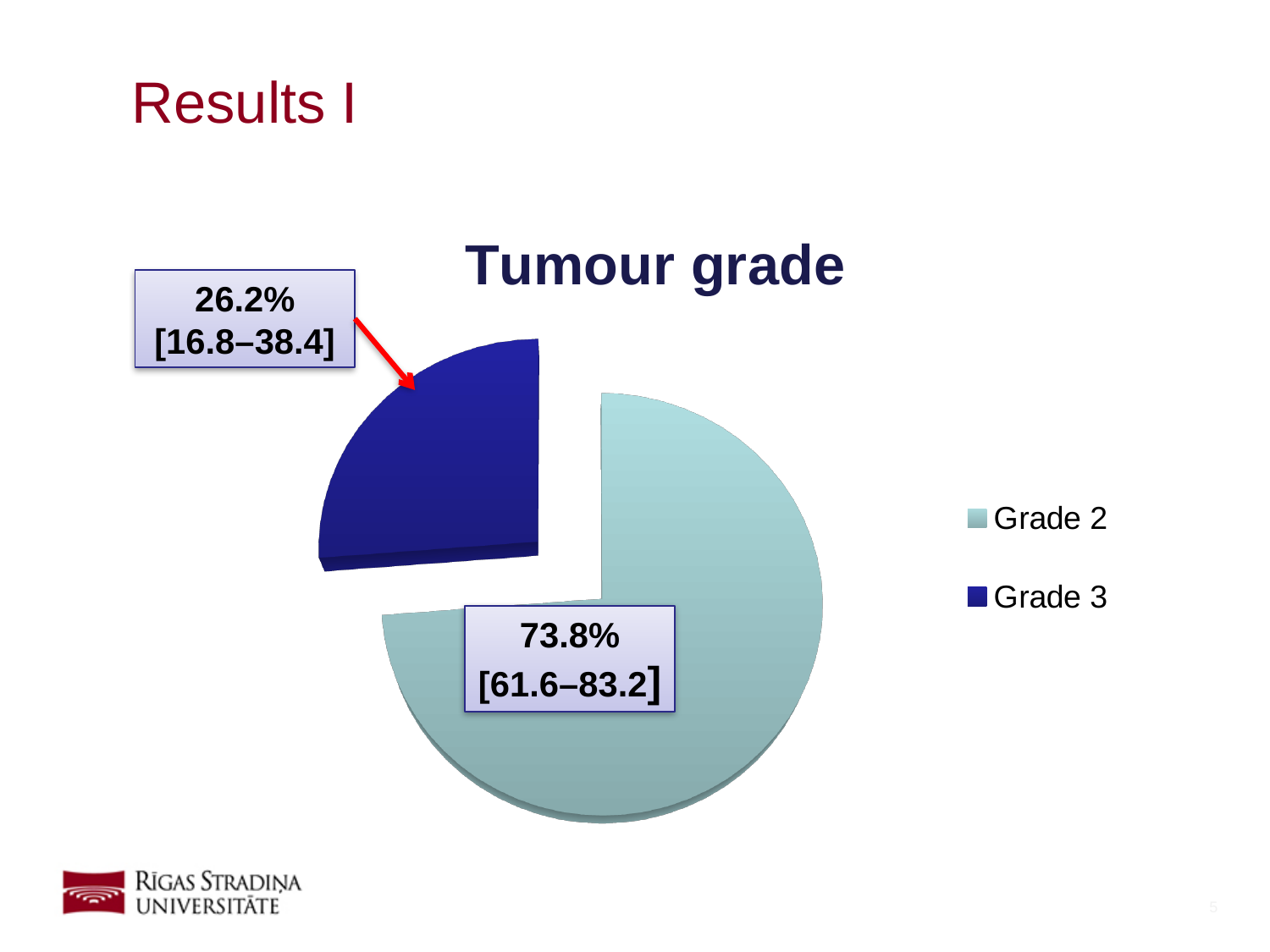
Which tumour grade has the smallest share of the pie? Grade 3 Which tumour grade has the largest share of the pie? Grade 2 How many entries does the legend list? 2 How many slices does the pie chart have? 2 What percentage of the pie is Grade 2? 73.8% What percentage of the pie is Grade 3? 26.2% What confidence interval is shown for the Grade 3 slice? [16.8–38.4] What type of chart is shown on the slide? pie chart What is the title of the chart? Tumour grade What colour is the Grade 3 slice in the pie chart? dark blue What is the difference in percentage points between the Grade 2 and Grade 3 shares? 47.6 Which is larger, the share for Grade 2 or the share for Grade 3? Grade 2